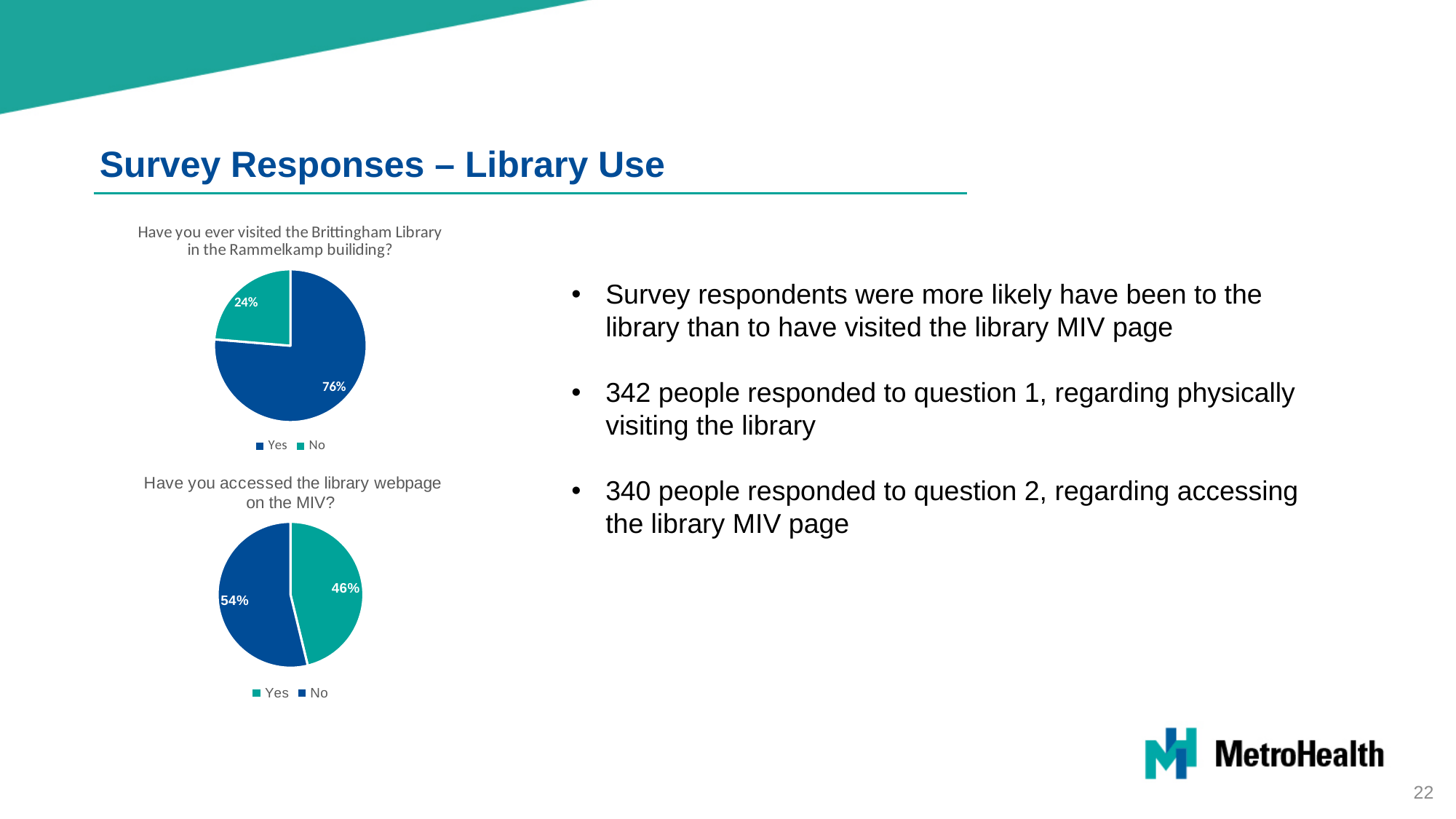
What type of chart is used for the top chart about visiting the Brittingham Library? Pie chart Is the Yes share in the top chart about visiting the Brittingham Library larger or smaller than the Yes share in the bottom chart about the MIV webpage? larger In the bottom chart, 'Have you accessed the library webpage on the MIV?', what share of respondents answered No? 54% In the top chart about visiting the Brittingham Library, what is the difference in percentage points between the Yes and No slices? 52 percentage points In the top chart, 'Have you ever visited the Brittingham Library in the Rammelkamp builiding?', what share of respondents answered No? 24% How many slices does the bottom chart about accessing the library webpage on the MIV have? 2 In the bottom chart about accessing the library webpage on the MIV, what is the difference in percentage points between the No and Yes slices? 8 percentage points In the bottom chart about accessing the library webpage on the MIV, which response has the smaller slice? Yes In the top chart about visiting the Brittingham Library, which response has the larger slice? Yes In the bottom chart, 'Have you accessed the library webpage on the MIV?', what share of respondents answered Yes? 46% What two entries does the legend of the top chart about visiting the Brittingham Library list? Yes and No